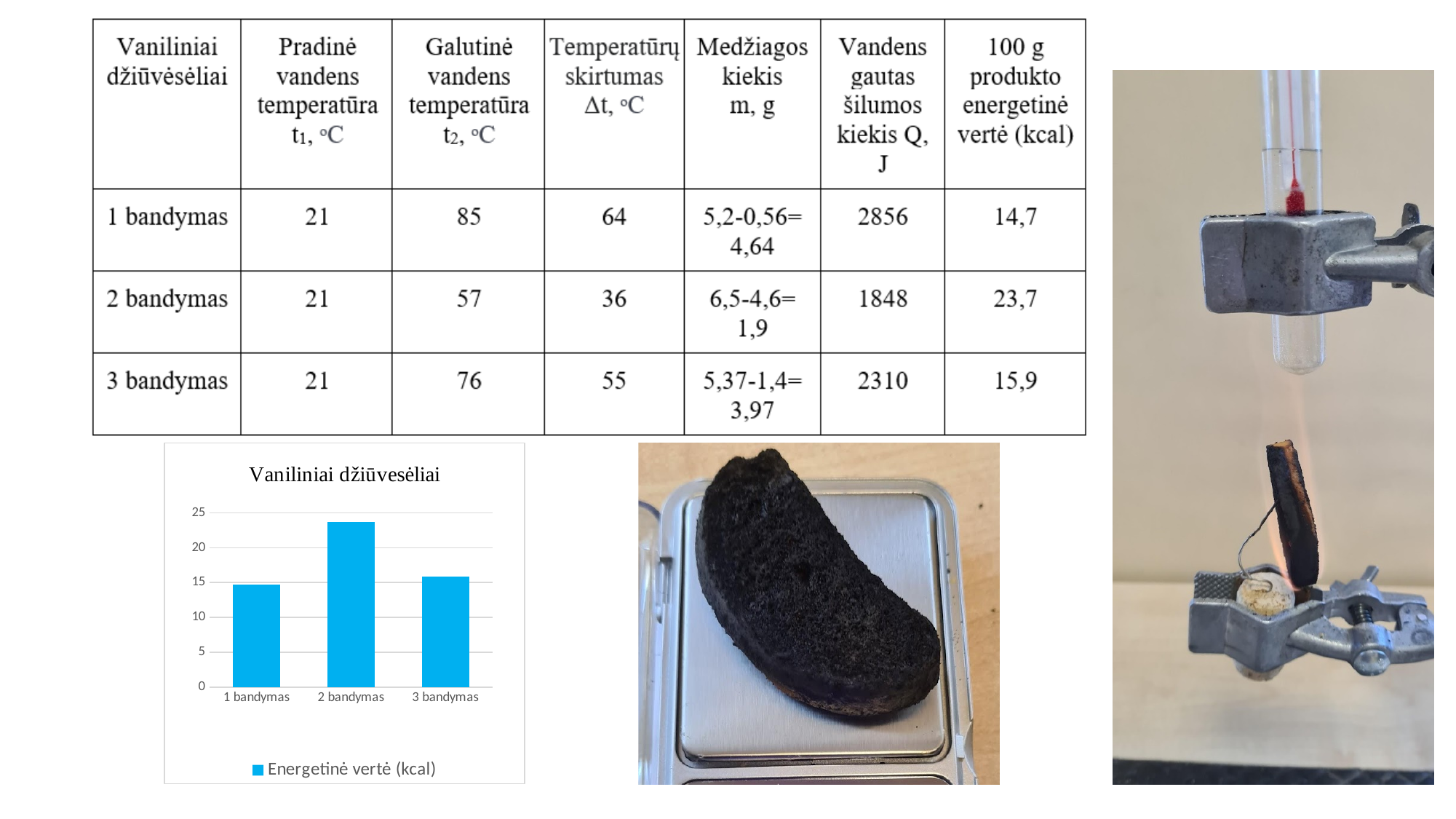
Which is larger in the chart, the value for 2 bandymas or the value for 3 bandymas? 2 bandymas How many series does the chart legend list? 1 What is the legend entry of the chart? Energetinė vertė (kcal) Is the value for 2 bandymas greater or less than 25? less Is the value for 2 bandymas greater or less than 20? greater What is the title of the chart? Vaniliniai džiūvesėliai Which category has the lowest bar in the chart? 1 bandymas Is the value for 3 bandymas greater or less than 15? greater How many bars are plotted in the chart? 3 What kind of chart is shown on the slide? bar chart Which category has the highest bar in the chart? 2 bandymas